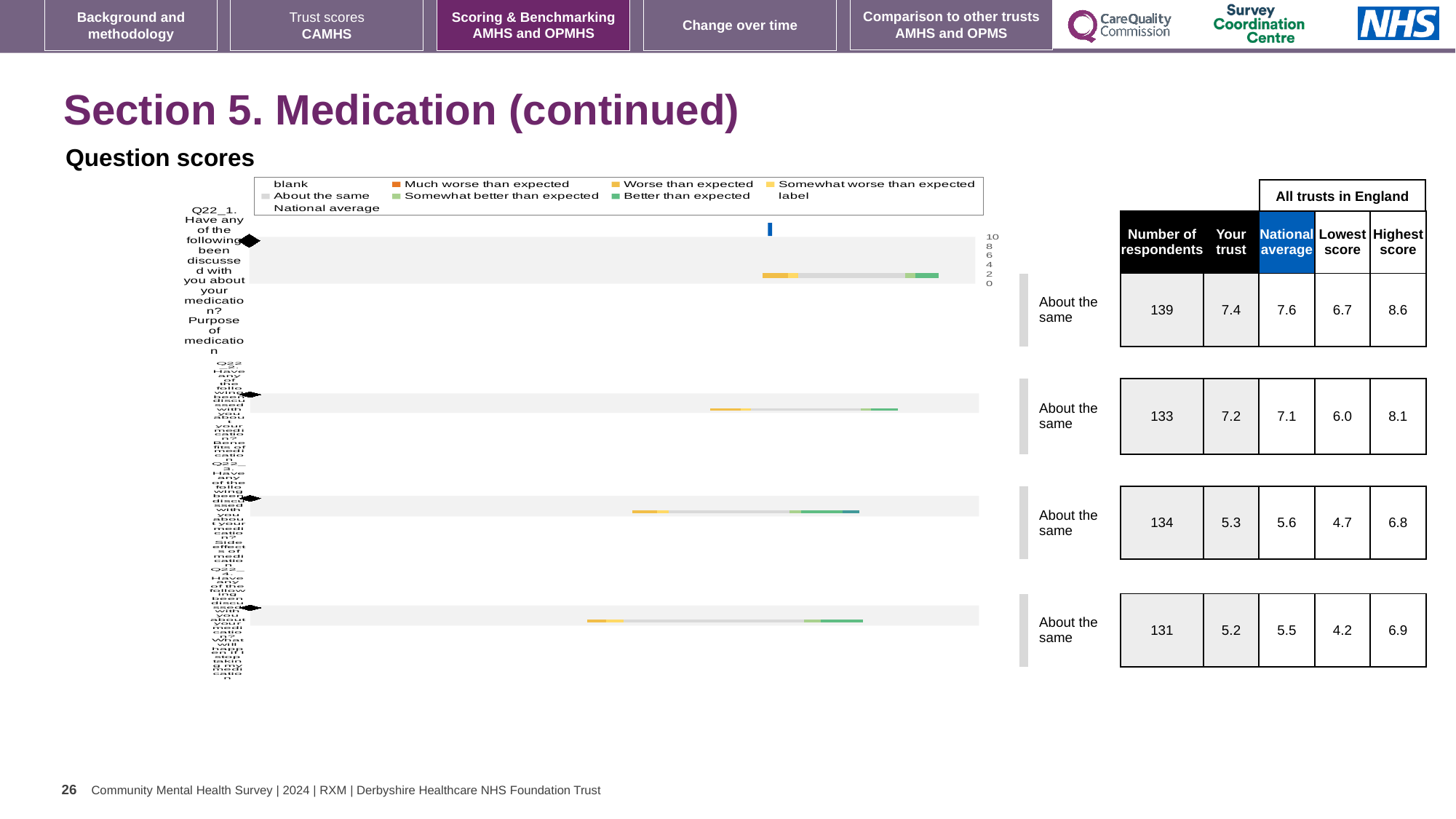
What kind of chart is used to show the question scores on this slide? Bar chart Which question has the highest 'Your trust' score? Q22_1 (Purpose of medication) In the legend, what colour represents 'Much worse than expected'? Orange What is the lowest score among all trusts in England for Q22_4 (What will happen if I stop taking my medication)? 4.2 Is the 'Your trust' score for Q22_2 (Benefits of medication) larger or smaller than its national average? Larger What is the maximum value shown on the chart's score axis? 10 Which question has the lowest 'Your trust' score? Q22_4 (What will happen if I stop taking my medication) What is the highest score among all trusts in England for Q22_3 (Side effects of medication)? 6.8 How many question charts (bars) are shown under 'Question scores'? 4 What benchmark category is shown next to the chart for Q22_1 (Purpose of medication)? About the same What is the 'Your trust' score for Q22_1 (Purpose of medication)? 7.4 What is the national average for Q22_2 (Benefits of medication)? 7.1